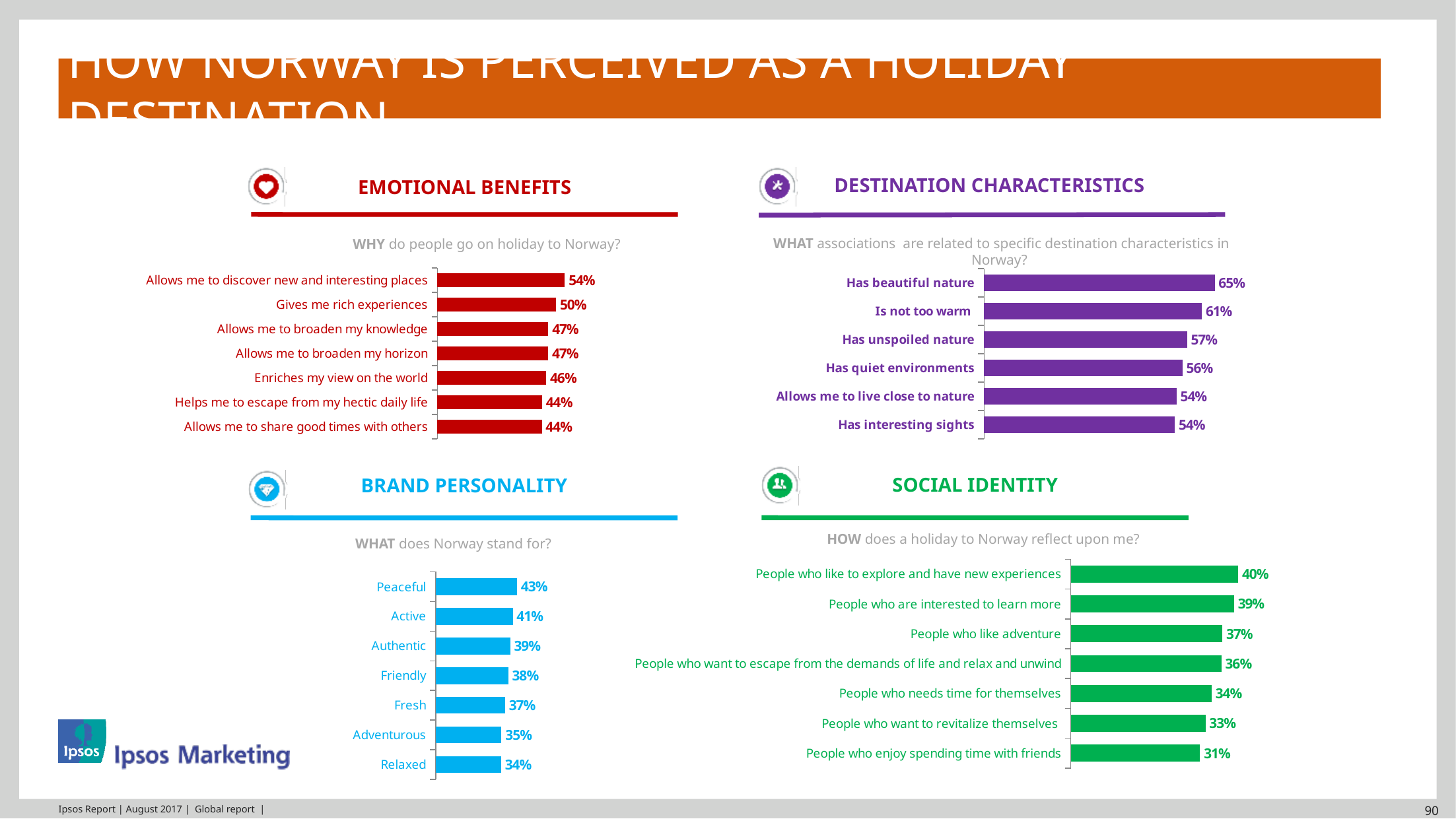
In the Social Identity chart, how many categories are shown? 7 In the Social Identity chart, what is the difference between "People who like to explore and have new experiences" and "People who enjoy spending time with friends"? 9% In the Brand Personality chart, what is the value for "Friendly"? 38% In the Brand Personality chart, which is larger: "Active" or "Fresh"? Active In the Destination Characteristics chart, what is the value for "Has unspoiled nature"? 57% In the Emotional Benefits chart, which category has the highest value? Allows me to discover new and interesting places In the Destination Characteristics chart, how many categories are shown? 6 What type of chart is used in the Emotional Benefits section? Bar chart In the Brand Personality chart, which category has the lowest value? Relaxed In the Destination Characteristics chart, what is the difference between "Has beautiful nature" and "Is not too warm"? 4% In the Social Identity chart, what is the value for "People who want to revitalize themselves"? 33% In the Emotional Benefits chart, what is the value for "Gives me rich experiences"? 50%